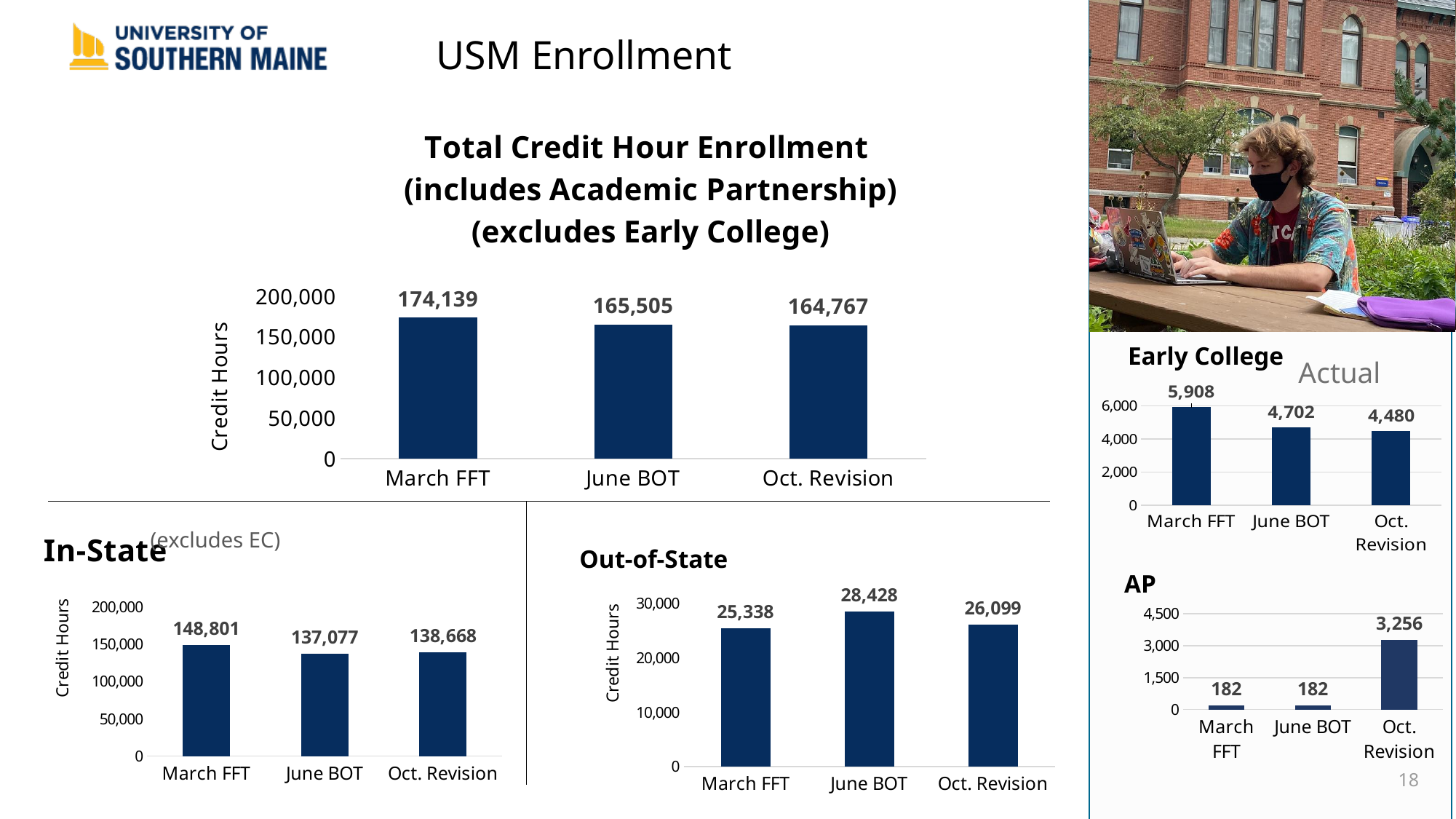
In the Out-of-State chart, which category has the highest value? June BOT In the Early College chart, do the values rise or fall from March FFT to Oct. Revision? fall In the Early College chart, what is the value for March FFT? 5,908 In the Total Credit Hour Enrollment chart, what is the difference between March FFT and June BOT? 8,634 In the Out-of-State chart, what is the value for Oct. Revision? 26,099 In the In-State chart, what is the value for June BOT? 137,077 In the Total Credit Hour Enrollment chart, what is the value for March FFT? 174,139 In the AP chart, what is the value for Oct. Revision? 3,256 In the In-State chart, which is larger, June BOT or Oct. Revision? Oct. Revision How many categories does the AP chart show? 3 What kind of chart is the Out-of-State chart? bar chart In the Total Credit Hour Enrollment chart, which category has the lowest value? Oct. Revision